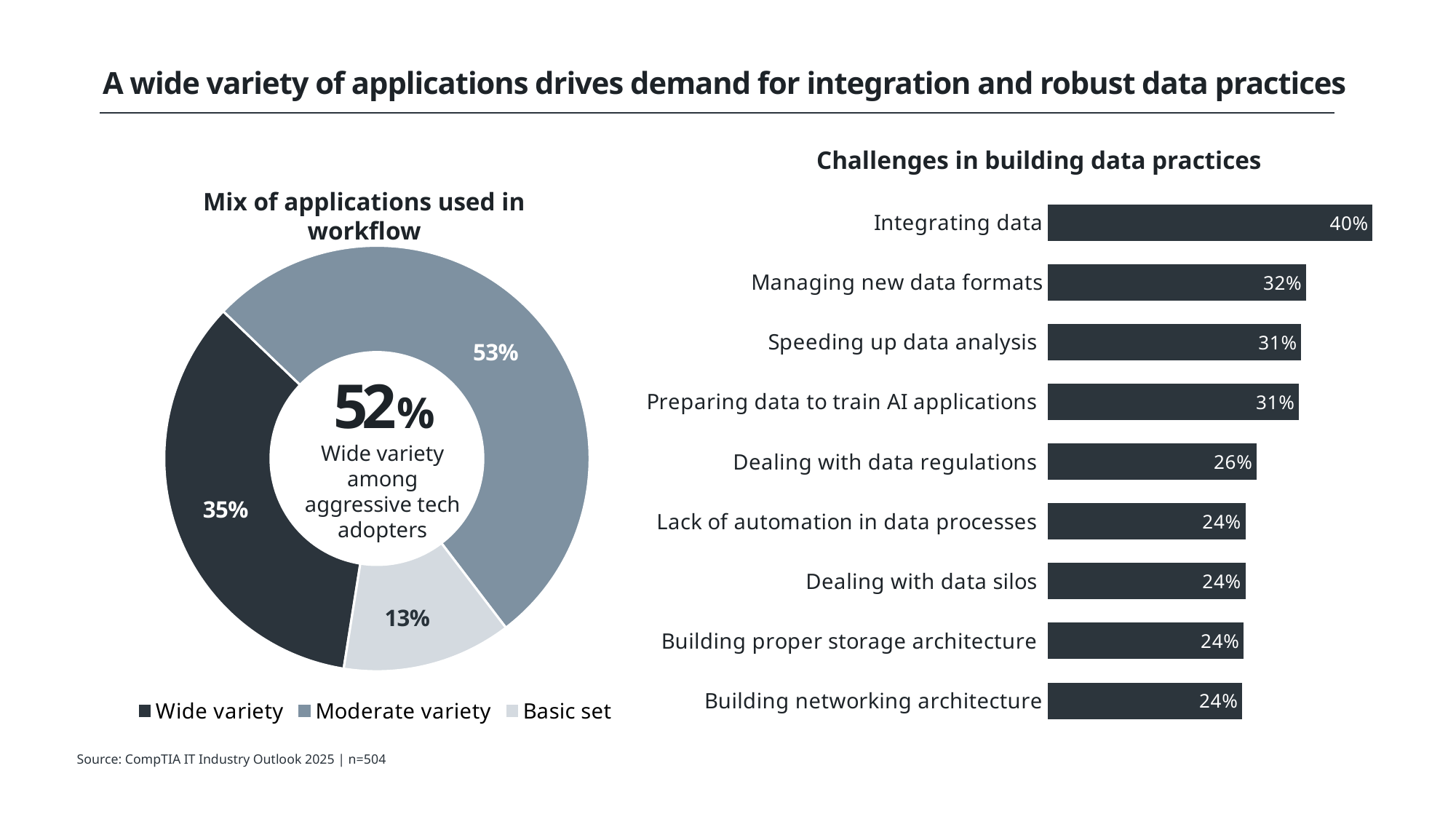
In the 'Mix of applications used in workflow' chart, how many entries does the legend list? 3 In the 'Challenges in building data practices' chart, which is larger: Speeding up data analysis or Dealing with data silos? Speeding up data analysis What kind of chart is 'Mix of applications used in workflow'? Doughnut chart In the 'Challenges in building data practices' chart, what is the difference between Integrating data and Managing new data formats? 8% In the 'Challenges in building data practices' chart, what is the value for Integrating data? 40% In the 'Mix of applications used in workflow' chart, which category has the largest share? Moderate variety In the 'Mix of applications used in workflow' chart, what share is labelled for Basic set? 13% How many categories are shown in the 'Challenges in building data practices' chart? 9 What kind of chart is 'Challenges in building data practices'? Bar chart In the 'Challenges in building data practices' chart, what is the value for Dealing with data regulations? 26% In the 'Mix of applications used in workflow' chart, what share is labelled for Moderate variety? 53% In the 'Challenges in building data practices' chart, which category has the highest value? Integrating data